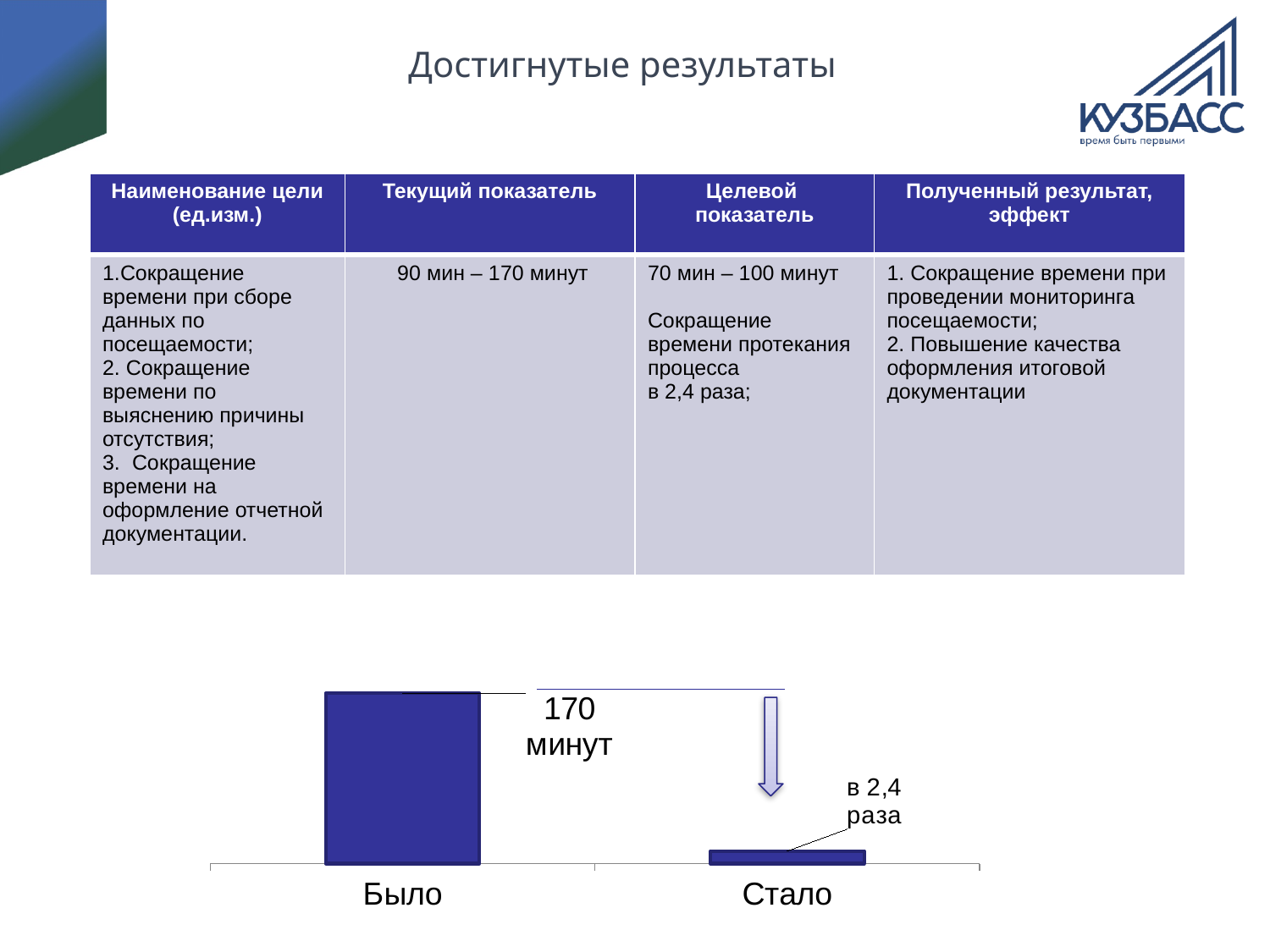
Do the bar values rise or fall from "Было" to "Стало"? fall How many categories are plotted in the bar chart? 2 What kind of chart is shown at the bottom of the slide? bar chart What are the two category labels on the x axis of the bar chart? Было, Стало What annotation is attached to the "Стало" bar? в 2,4 раза Which category has the lowest bar in the chart? Стало Which category has the highest bar in the chart? Было What value is labelled on the bar for "Было"? 170 минут Which bar is taller, "Было" or "Стало"? Было